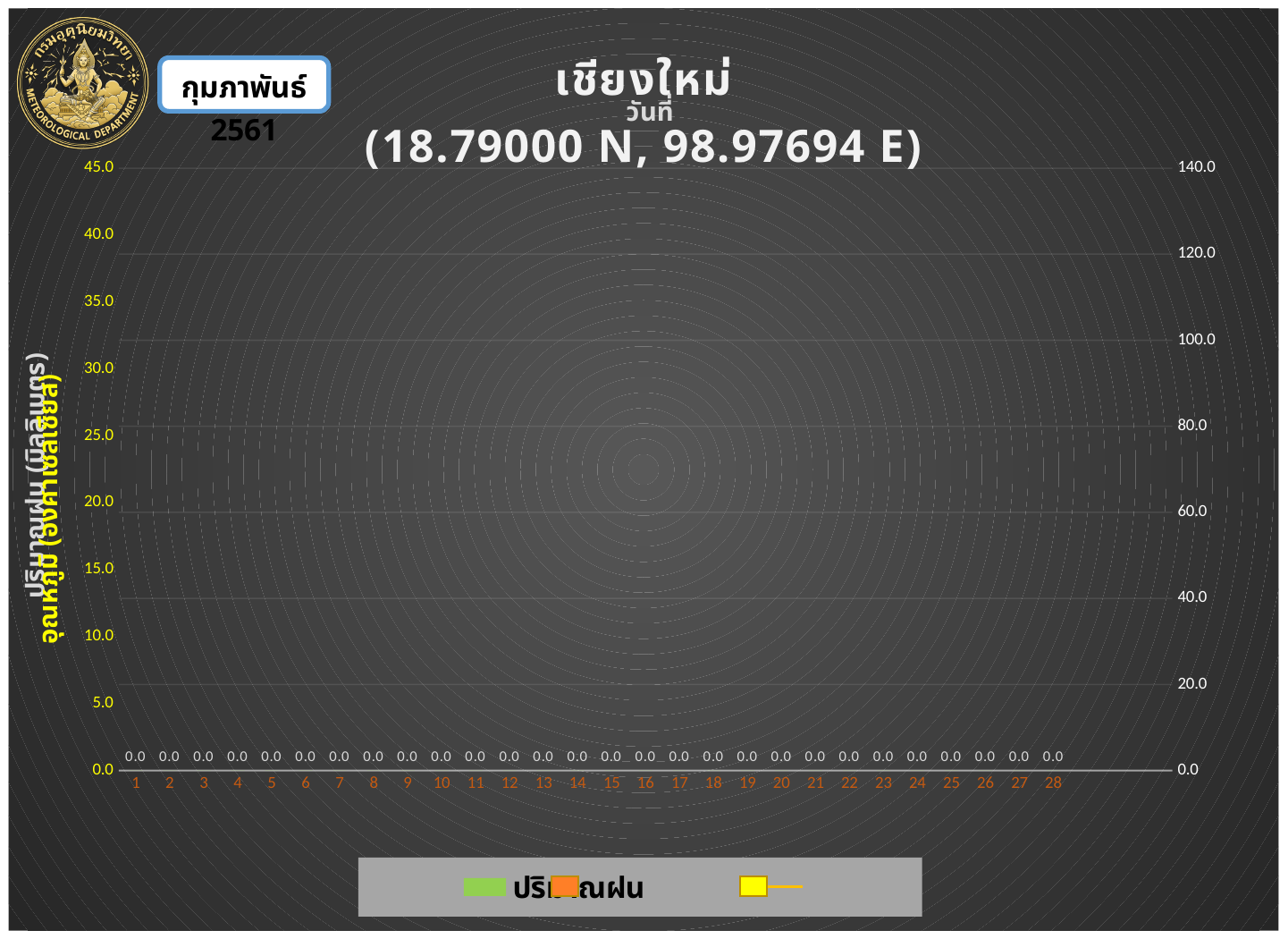
Is the labelled value for day 10 greater or less than 5.0 on the left axis? less What is the difference between the labelled values for day 1 and day 28? 0.0 What is the data label shown for day 28 on the chart? 0.0 What is the data label shown for day 15 on the chart? 0.0 Do the labelled values rise, fall, or stay flat from day 1 to day 28? stay flat What is the data label shown for day 1 on the chart? 0.0 How many days (categories) are shown along the x axis of the chart? 28 What is the highest tick value shown on the right vertical axis? 140.0 What is the highest tick value shown on the left vertical axis? 45.0